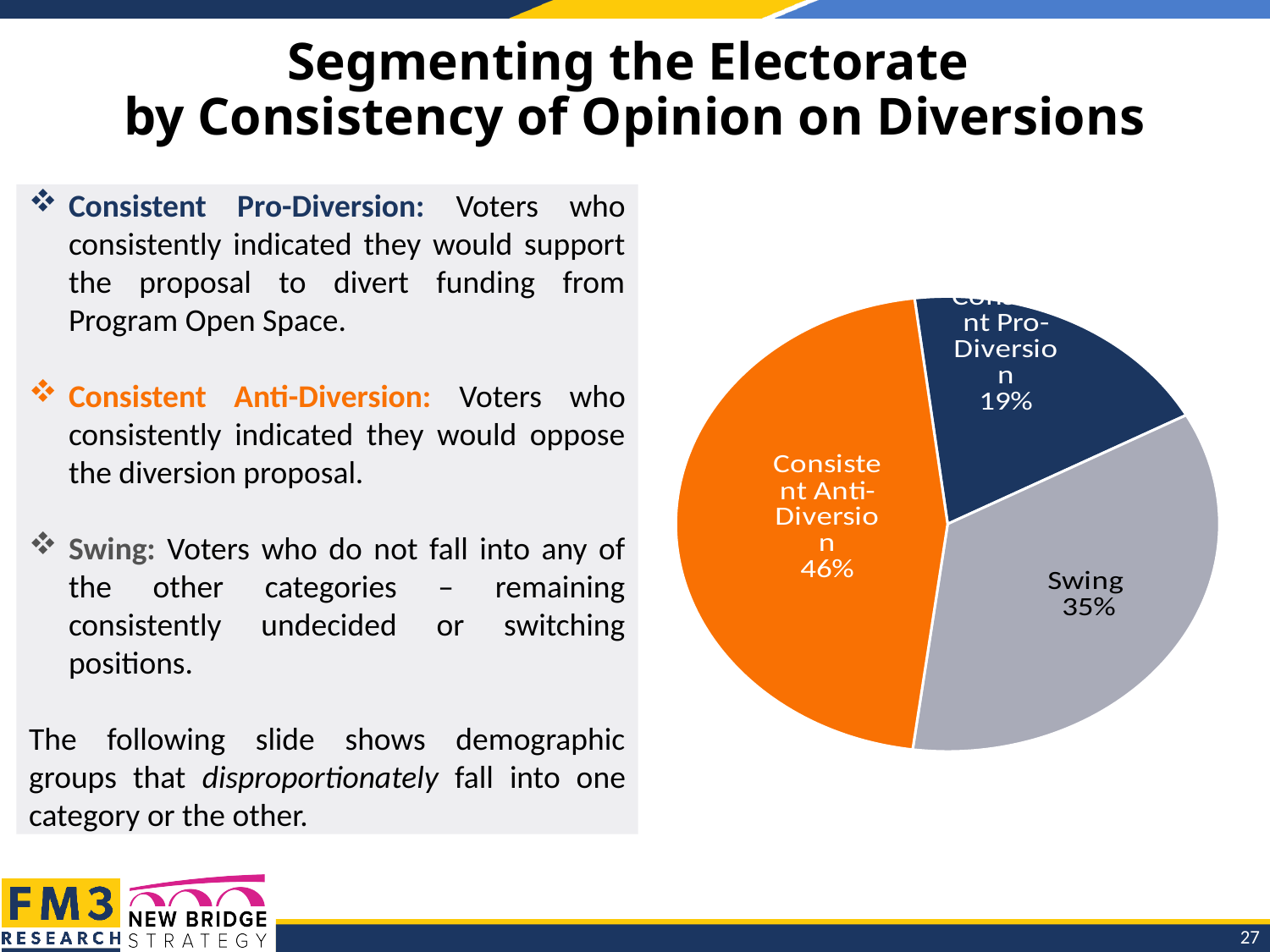
Which is larger, the Swing share or the Consistent Pro-Diversion share? Swing What is the difference in percentage points between the Consistent Anti-Diversion and Swing shares? 11 What is the difference in percentage points between the Swing and Consistent Pro-Diversion shares? 16 How many segments does the pie chart have? 3 What colour is the Swing slice? gray Which segment has the smallest share of the pie? Consistent Pro-Diversion What share of the electorate is Consistent Anti-Diversion? 46% Which segment has the largest share of the pie? Consistent Anti-Diversion What kind of chart is shown on the slide? pie chart What colour is the Consistent Anti-Diversion slice? orange What share of the electorate is Swing? 35% What share of the electorate is Consistent Pro-Diversion? 19%